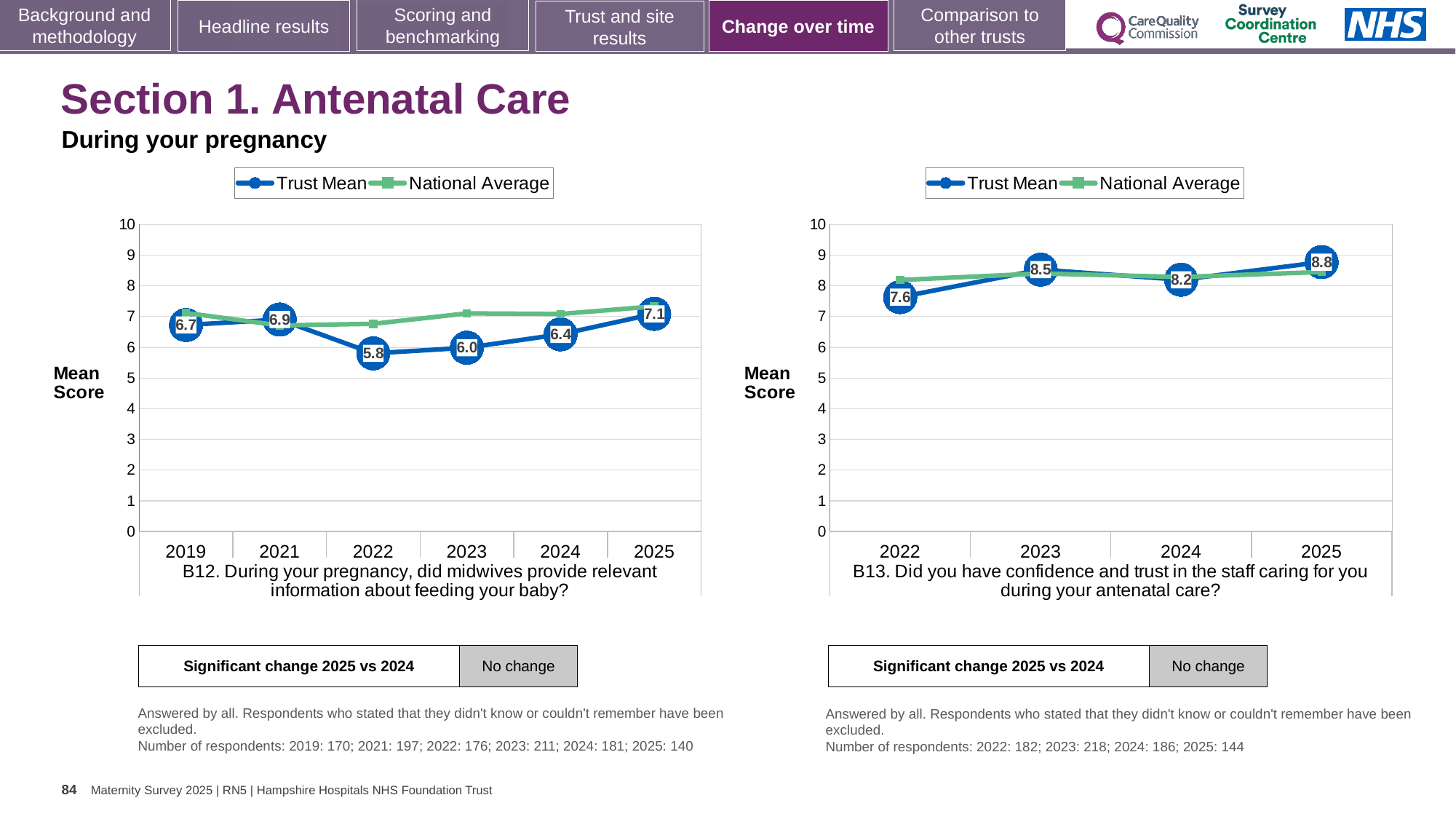
In the left chart (B12), is the National Average for 2023 greater or less than 6? greater How many years are plotted on the x axis of the left chart (B12)? 6 In the left chart (B12), what is the Trust Mean score for 2022? 5.8 How many series does the legend of the right chart (B13) list? 2 In the right chart (B13), does the Trust Mean rise or fall from 2023 to 2024? Fall What kind of chart is the right chart (B13)? Line chart In the left chart (B12), what is the Trust Mean score for 2025? 7.1 In the right chart (B13), what is the difference between the Trust Mean scores for 2025 and 2022? 1.2 In the right chart (B13), what is the Trust Mean score for 2022? 7.6 In the left chart (B12), which year has the lowest Trust Mean score? 2022 In the left chart (B12), which is larger, the Trust Mean score for 2021 or for 2024? 2021 In the right chart (B13), which year has the highest Trust Mean score? 2025